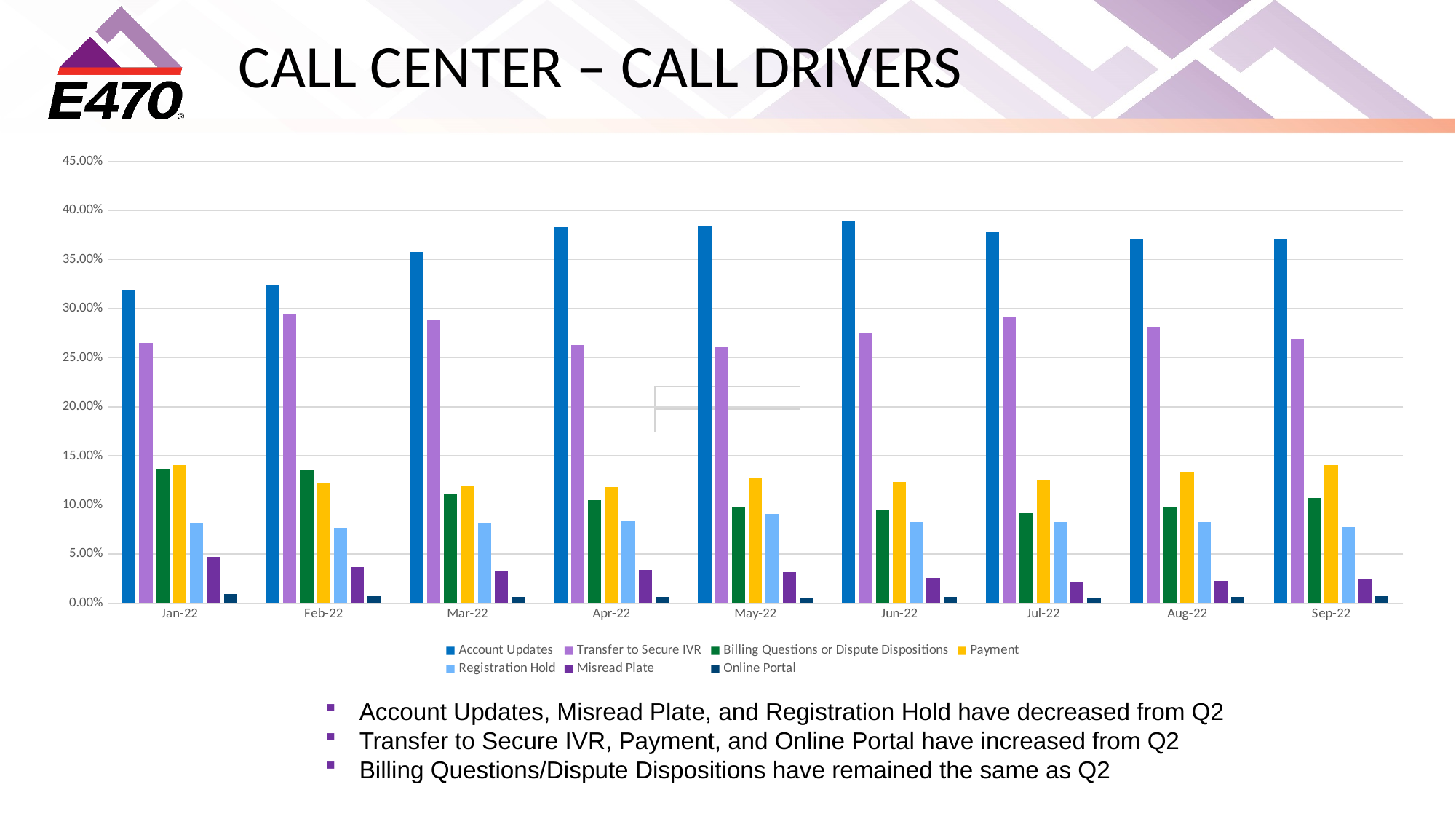
In which month is the Misread Plate bar the highest? Jan-22 What kind of chart is shown on the slide? Bar chart In Jun-22, which is larger: Billing Questions or Dispute Dispositions or Payment? Payment Does the Account Updates series rise or fall from Jan-22 to Jun-22? Rise Is the value for Account Updates in Jan-22 greater or less than 30.00%? greater In which month is the Account Updates bar the highest? Jun-22 Is the value for Registration Hold in Jan-22 greater or less than 10.00%? less Is the value for Transfer to Secure IVR in Feb-22 greater or less than 25.00%? greater How many months are shown on the x axis of the chart? 9 How many series does the chart's legend list? 7